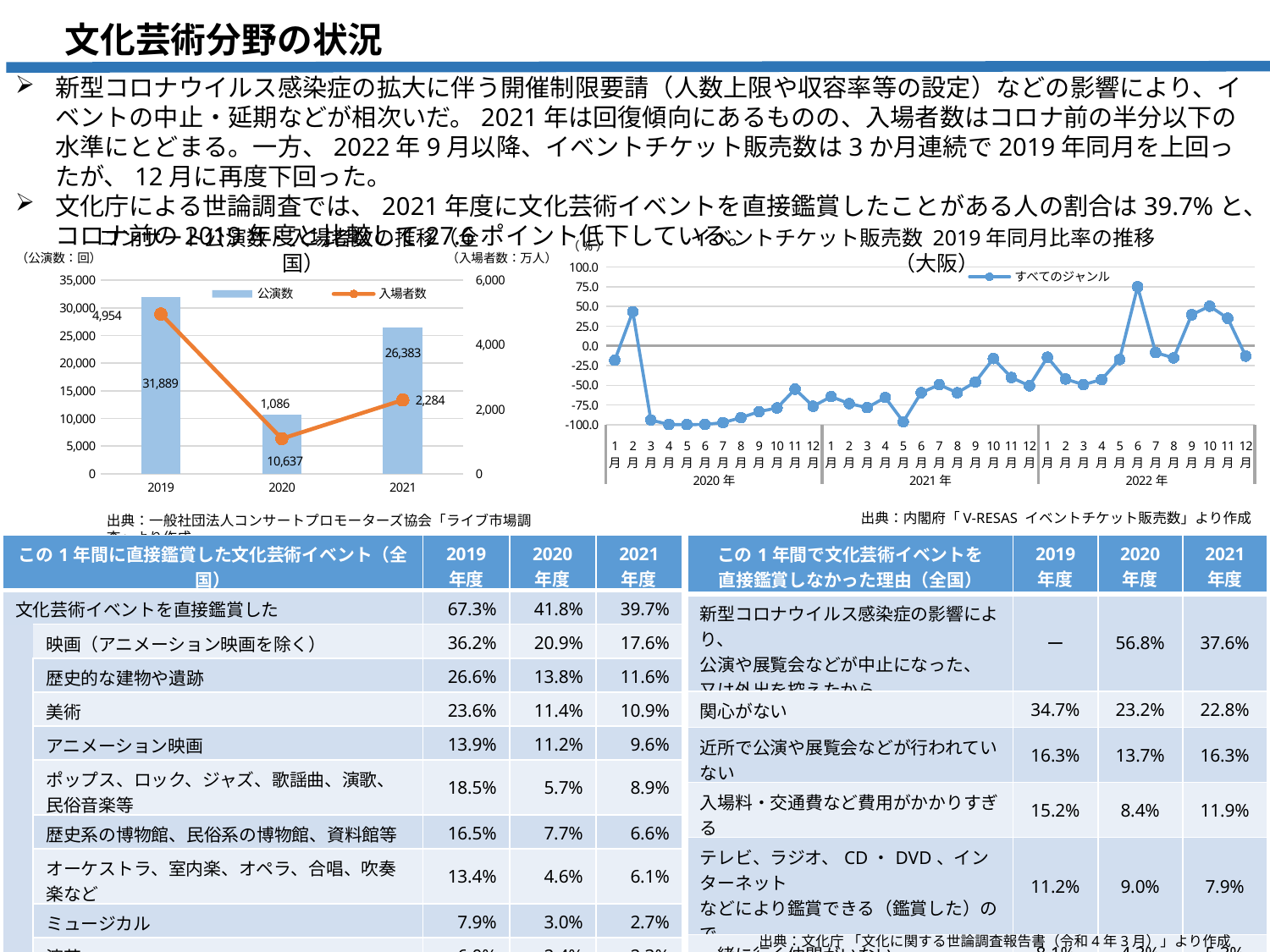
On the right chart (イベントチケット販売数 2019年同月比率の推移（大阪）), is the value for 2022年6月 greater or less than 50.0? greater On the left chart, what is the value of 入場者数 for 2020? 1,086 On the right chart (イベントチケット販売数 2019年同月比率の推移（大阪）), what is the name of the series shown in the legend? すべてのジャンル On the left chart, how many series does the legend list? 2 On the left chart, what is the value of 公演数 for 2021? 26,383 On the left chart, how many years are shown on the x axis? 3 On the left chart, which year has the lowest 公演数? 2020 On the left chart, which year has the highest 入場者数? 2019 On the left chart, what is the difference in 入場者数 between 2021 and 2020? 1,198 On the left chart, what is the value of 公演数 for 2019? 31,889 On the left chart, what is the difference in 公演数 between 2019 and 2020? 21,252 What kind of chart is the right chart (イベントチケット販売数 2019年同月比率の推移（大阪）)? Line chart